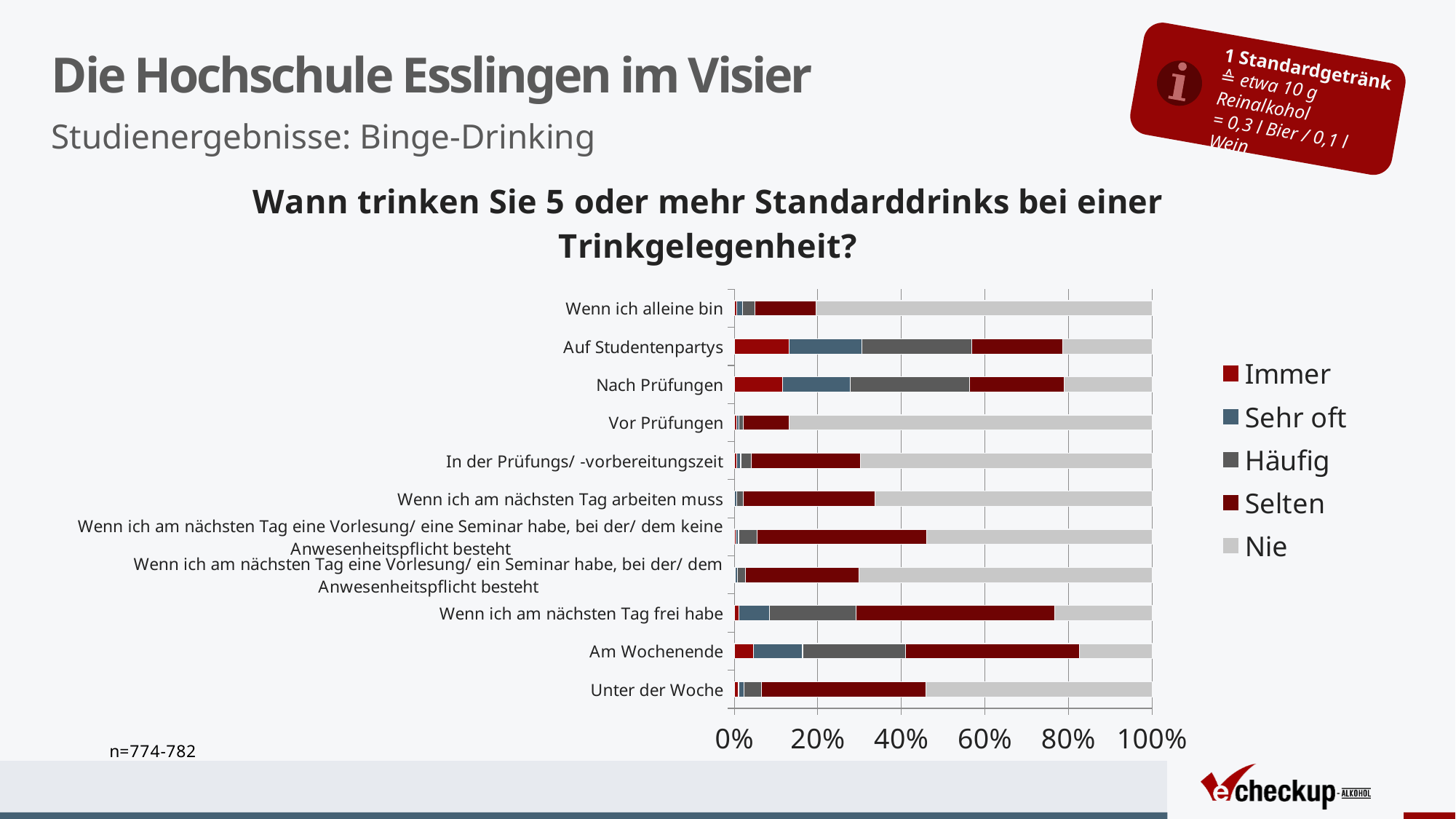
Which legend entry is shown in light grey? Nie How many series does the chart's legend list? 5 How many categories (drinking occasions) are listed on the chart's vertical axis? 11 Which category has the largest 'Nie' share: 'Vor Prüfungen' or 'Am Wochenende'? Vor Prüfungen Is the 'Selten' share for 'Wenn ich am nächsten Tag frei habe' greater or less than 20%? greater What is the title of the chart? Wann trinken Sie 5 oder mehr Standarddrinks bei einer Trinkgelegenheit? What kind of chart is shown on the slide? Stacked bar chart Is the 'Nie' share for 'Am Wochenende' greater or less than 40%? less Is the 'Immer' share for 'Auf Studentenpartys' greater or less than 20%? less Which category has the largest 'Nie' share overall? Vor Prüfungen Which has the larger 'Sehr oft' share: 'Auf Studentenpartys' or 'Unter der Woche'? Auf Studentenpartys